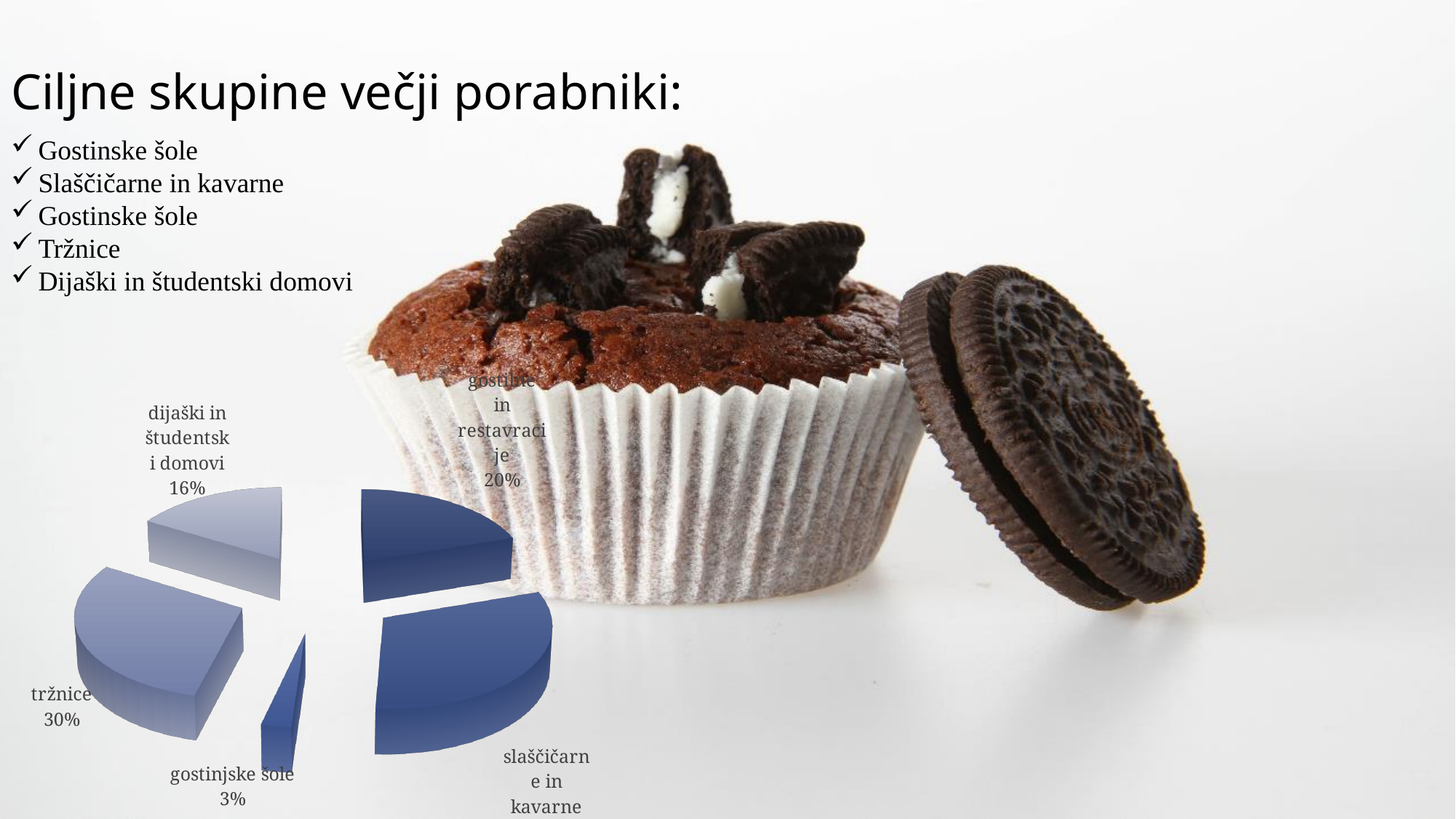
What share of the pie chart does tržnice have? 30% Which slice of the pie chart is the smallest? gostinjske šole What share of the pie chart does dijaški in študentski domovi have? 16% Which is larger in the pie chart, tržnice or dijaški in študentski domovi? tržnice What is the combined share of tržnice and gostilne in restavracije in the pie chart? 50% What kind of chart is shown on the slide? pie chart Which is larger in the pie chart, gostilne in restavracije or gostinjske šole? gostilne in restavracije What is the difference in percentage points between gostilne in restavracije and gostinjske šole in the pie chart? 17 What share of the pie chart does gostilne in restavracije have? 20% What is the difference in percentage points between tržnice and dijaški in študentski domovi in the pie chart? 14 How many slices does the pie chart have? 5 What share of the pie chart does gostinjske šole have? 3%